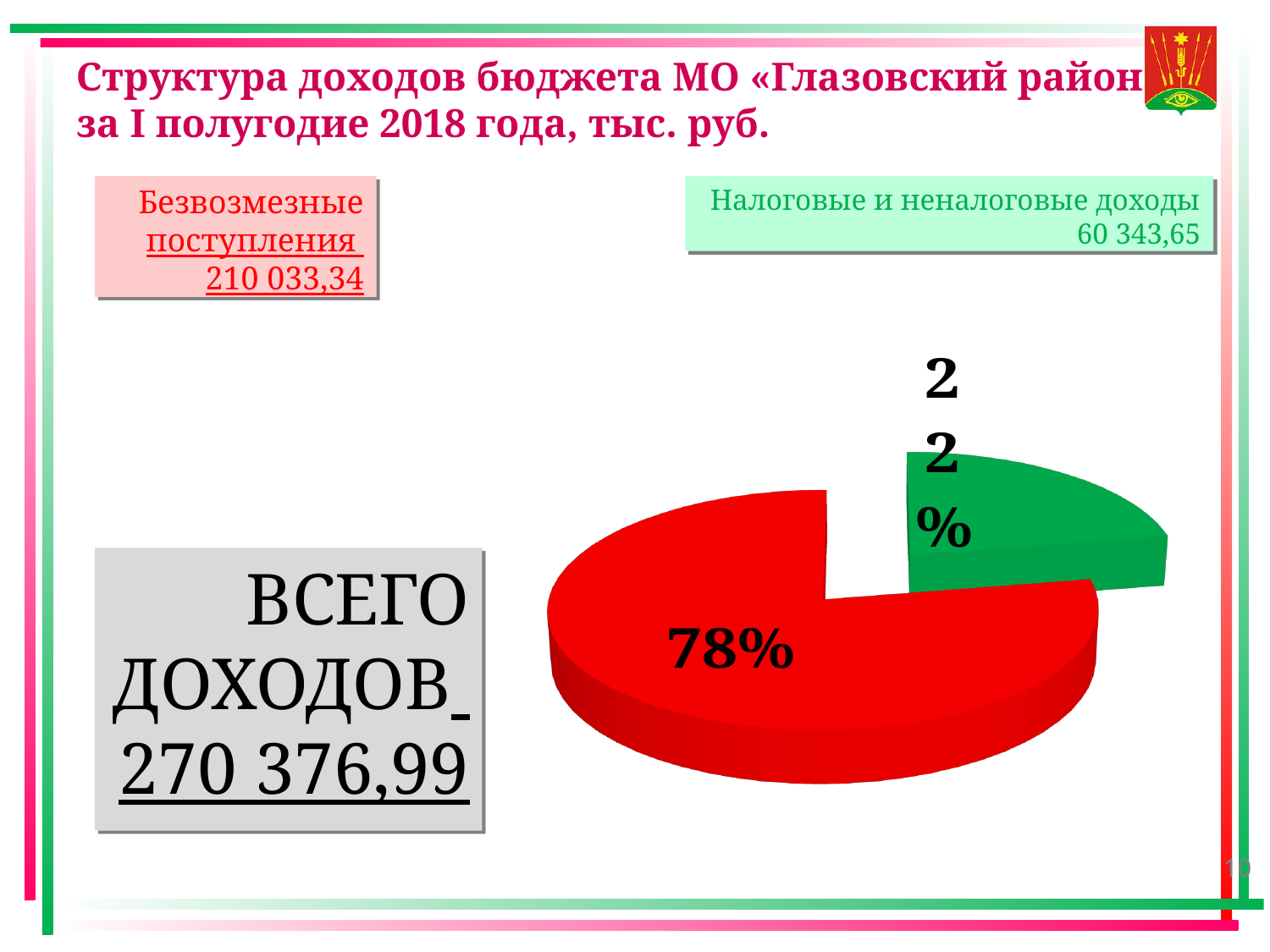
What colour is the slice representing 78% of the pie? red What share of the pie does the green slice (Налоговые и неналоговые доходы) represent? 22% By how many percentage points does the red slice exceed the green slice? 56 What kind of chart is shown on the slide? pie chart What is the total of all income (ВСЕГО ДОХОДОВ) shown on the slide? 270 376,99 What is the value shown for Налоговые и неналоговые доходы, in тыс. руб.? 60 343,65 Which category has the largest slice of the pie? Безвозмездные поступления Which category has the smallest slice of the pie? Налоговые и неналоговые доходы Which is larger: the share of Безвозмездные поступления or the share of Налоговые и неналоговые доходы? Безвозмездные поступления What share of the pie does the red slice (Безвозмездные поступления) represent? 78% How many slices does the pie chart have? 2 What is the value shown for Безвозмездные поступления, in тыс. руб.? 210 033,34